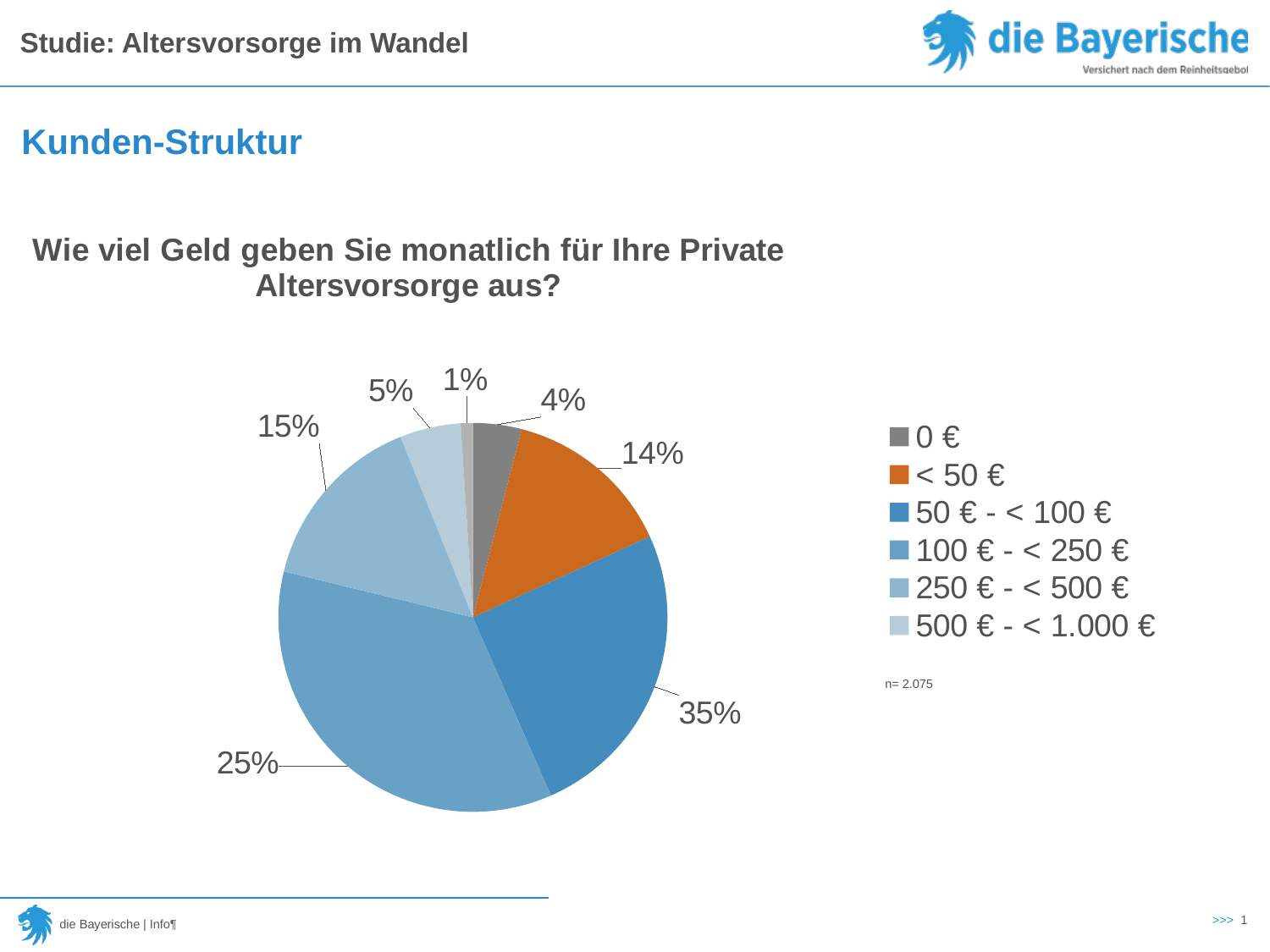
Which is larger, the share for < 50 € or the share for 250 € - < 500 €? 250 € - < 500 € What share of respondents spend 50 € - < 100 € monthly on private retirement provision? 35% What share of respondents spend 0 € monthly on private retirement provision? 4% What share of respondents spend 100 € - < 250 € monthly? 25% What share of respondents spend 250 € - < 500 € monthly? 15% How many categories does the legend of the pie chart list? 6 What kind of chart is shown on the slide? pie chart What share of respondents spend < 50 € monthly? 14% Which spending category has the largest share of the pie? 50 € - < 100 € What share of respondents spend 500 € - < 1.000 € monthly? 5% What is the sample size (n) stated next to the chart? n= 2.075 What is the difference in percentage points between the 50 € - < 100 € share and the 100 € - < 250 € share? 10